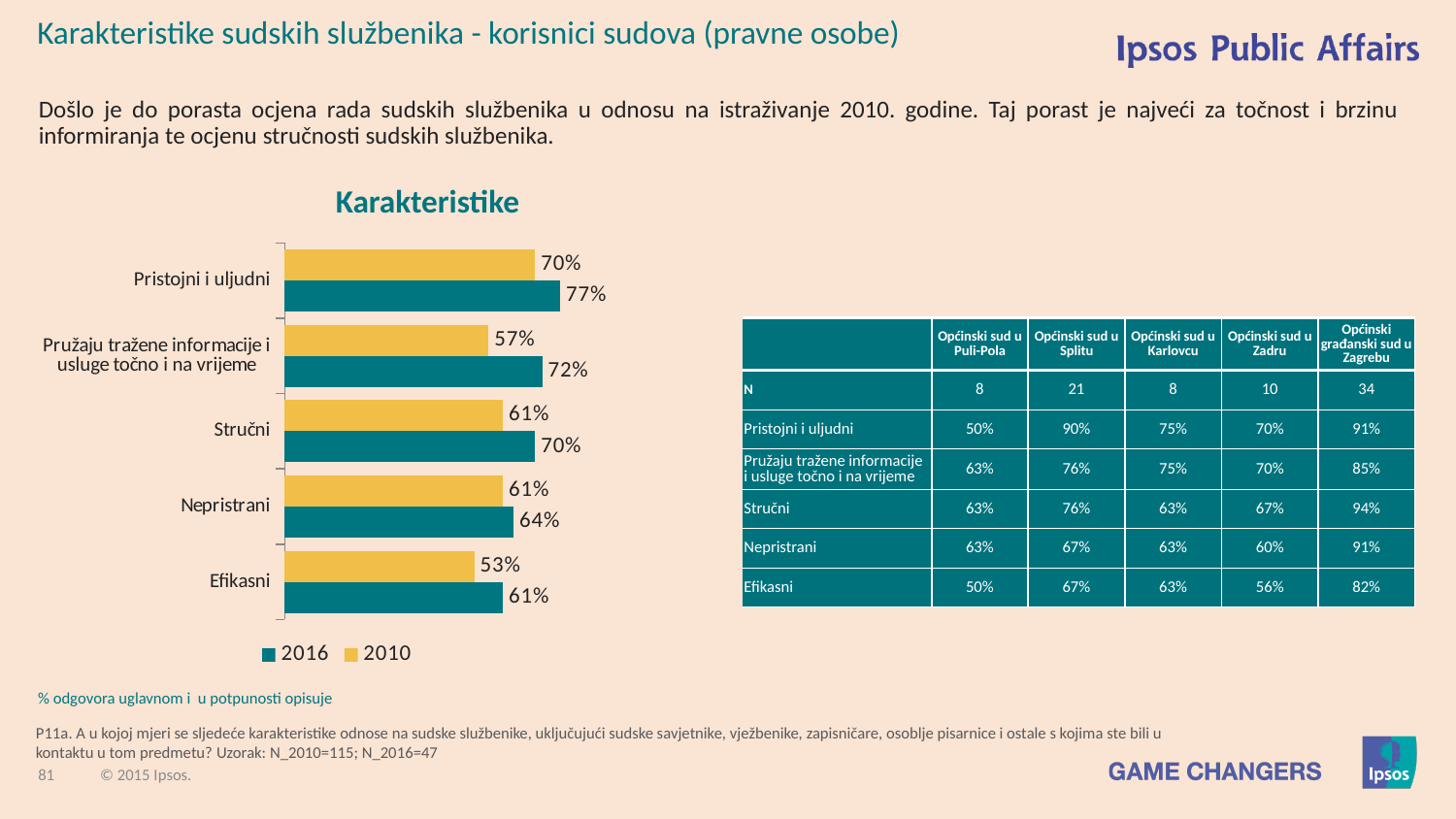
Which category has the lowest 2010 value in the Karakteristike chart? Efikasni How many series does the legend of the Karakteristike chart list? 2 What is the difference between the 2016 and 2010 values for Pružaju tražene informacije i usluge točno i na vrijeme in the Karakteristike chart? 15 percentage points What is the 2010 value for Efikasni in the Karakteristike chart? 53% How many categories are shown in the Karakteristike chart? 5 In the Karakteristike chart, which is larger: the 2016 value for Stručni or the 2016 value for Efikasni? 2016 value for Stručni Which category has the highest 2016 value in the Karakteristike chart? Pristojni i uljudni What is the 2010 value for Pružaju tražene informacije i usluge točno i na vrijeme in the Karakteristike chart? 57% What is the 2016 value for Pristojni i uljudni in the Karakteristike chart? 77% What is the difference between the 2016 and 2010 values for Nepristrani in the Karakteristike chart? 3 percentage points What type of chart is the Karakteristike chart? Bar chart Which colour represents the 2010 series in the Karakteristike chart? Yellow